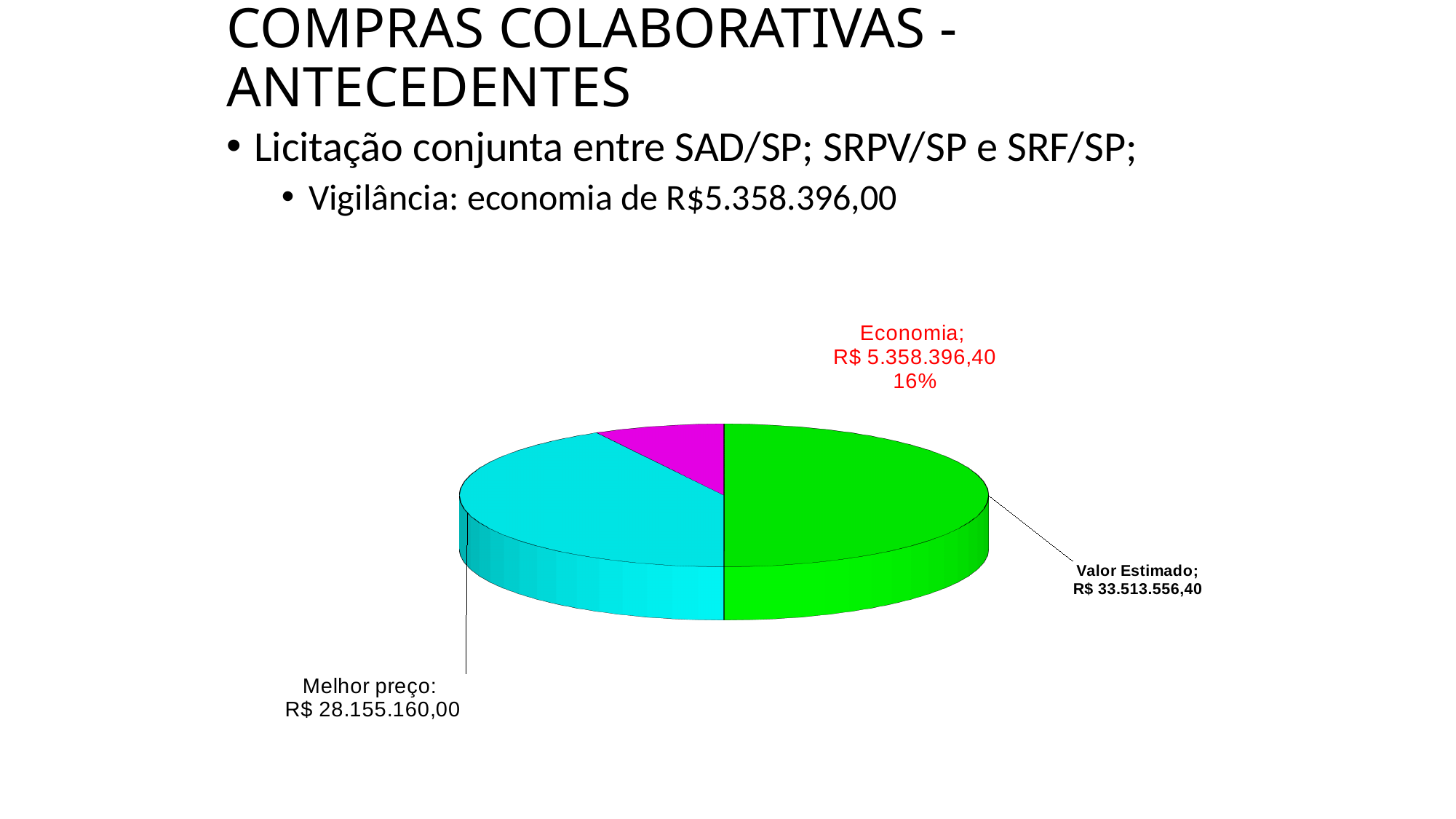
Which slice of the pie chart is the largest? Valor Estimado Which is larger, Valor Estimado or Melhor preço? Valor Estimado What is the difference between Valor Estimado and Economia? R$ 28.155.160,00 What colour is the Economia slice in the pie chart? magenta What is the value shown for Economia? R$ 5.358.396,40 What is the difference between Valor Estimado and Melhor preço? R$ 5.358.396,40 What is the value shown for Valor Estimado? R$ 33.513.556,40 Which slice of the pie chart is the smallest? Economia What kind of chart is shown on the slide? pie chart What is the value shown for Melhor preço? R$ 28.155.160,00 What percentage share of the pie does Economia represent? 16% How many slices does the pie chart have? 3